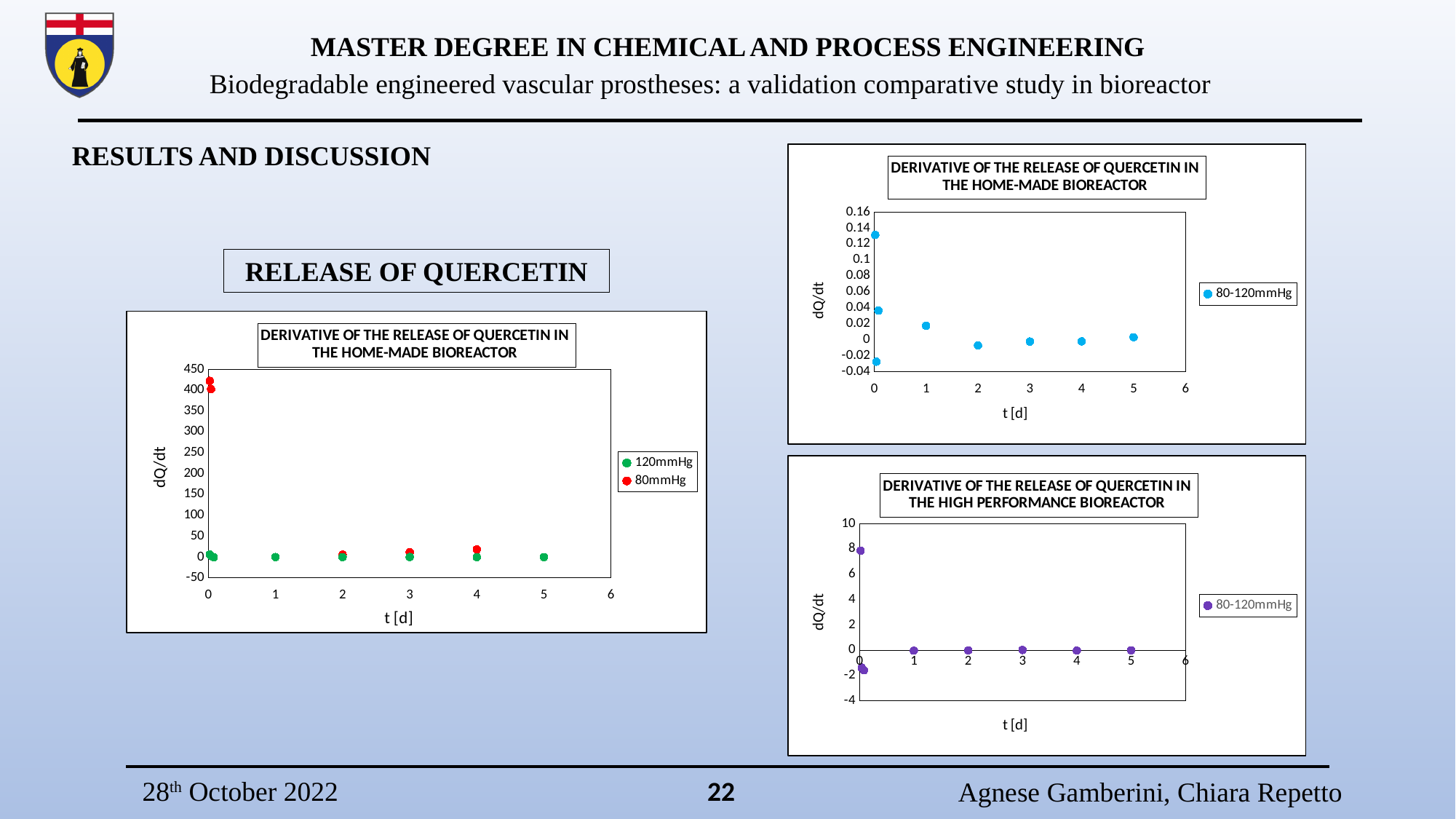
Which series are listed in the legend of the left chart? 120mmHg and 80mmHg In the top-right chart, is the highest value at t = 0 greater or less than 0.1? greater In the left chart, at t = 4, which series has the larger value, 80mmHg or 120mmHg? 80mmHg In the bottom-right chart (high performance bioreactor), is the highest value at t = 0 greater or less than 6? greater What kind of chart is the chart on the left of the slide? scatter chart How many series does the legend of the left chart list? 2 How many series does the legend of the top-right chart list? 1 In the left chart, is the highest value of the 80mmHg series at t = 0 greater or less than 350? greater In the top-right chart, do the values generally rise or fall from t = 0 to t = 2? fall What is the x-axis label of the top-right chart? t [d]